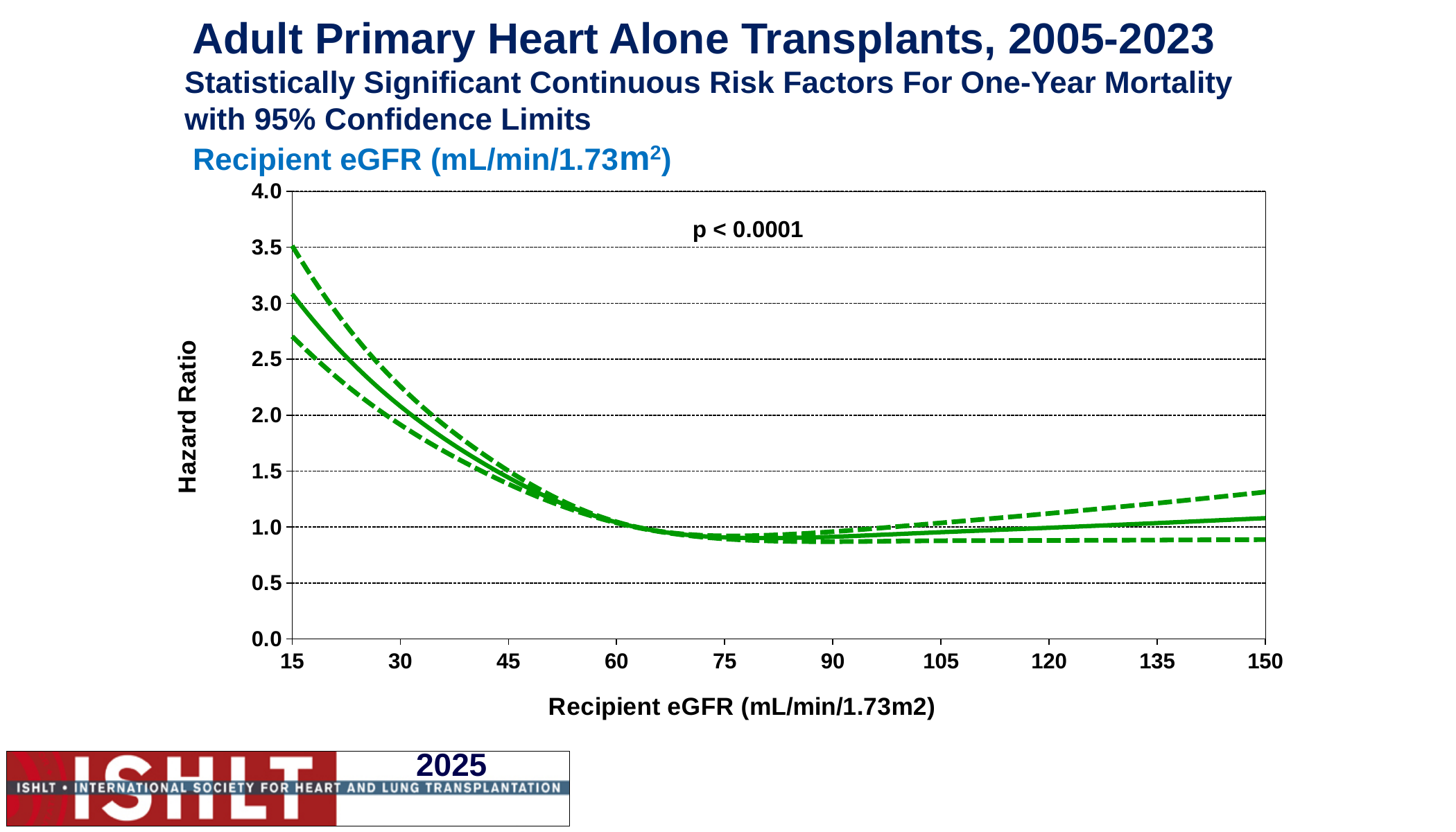
What is the label of the x axis? Recipient eGFR (mL/min/1.73m2) What kind of chart is shown on the slide? line chart Which is larger, the hazard ratio of the solid line at a recipient eGFR of 30 or at 60? 30 Is the hazard ratio of the solid line at a recipient eGFR of 15 greater or less than 2.5? greater At which recipient eGFR value on the x axis is the hazard ratio of the solid line highest? 15 Is the hazard ratio of the solid line at a recipient eGFR of 150 greater or less than 1.5? less Is the hazard ratio of the solid line at a recipient eGFR of 75 greater or less than 1.0? less What is the label of the y axis? Hazard Ratio How many lines are plotted on the chart? 3 Does the hazard ratio rise or fall as recipient eGFR increases from 15 to 75? fall What p-value is printed on the chart? p < 0.0001